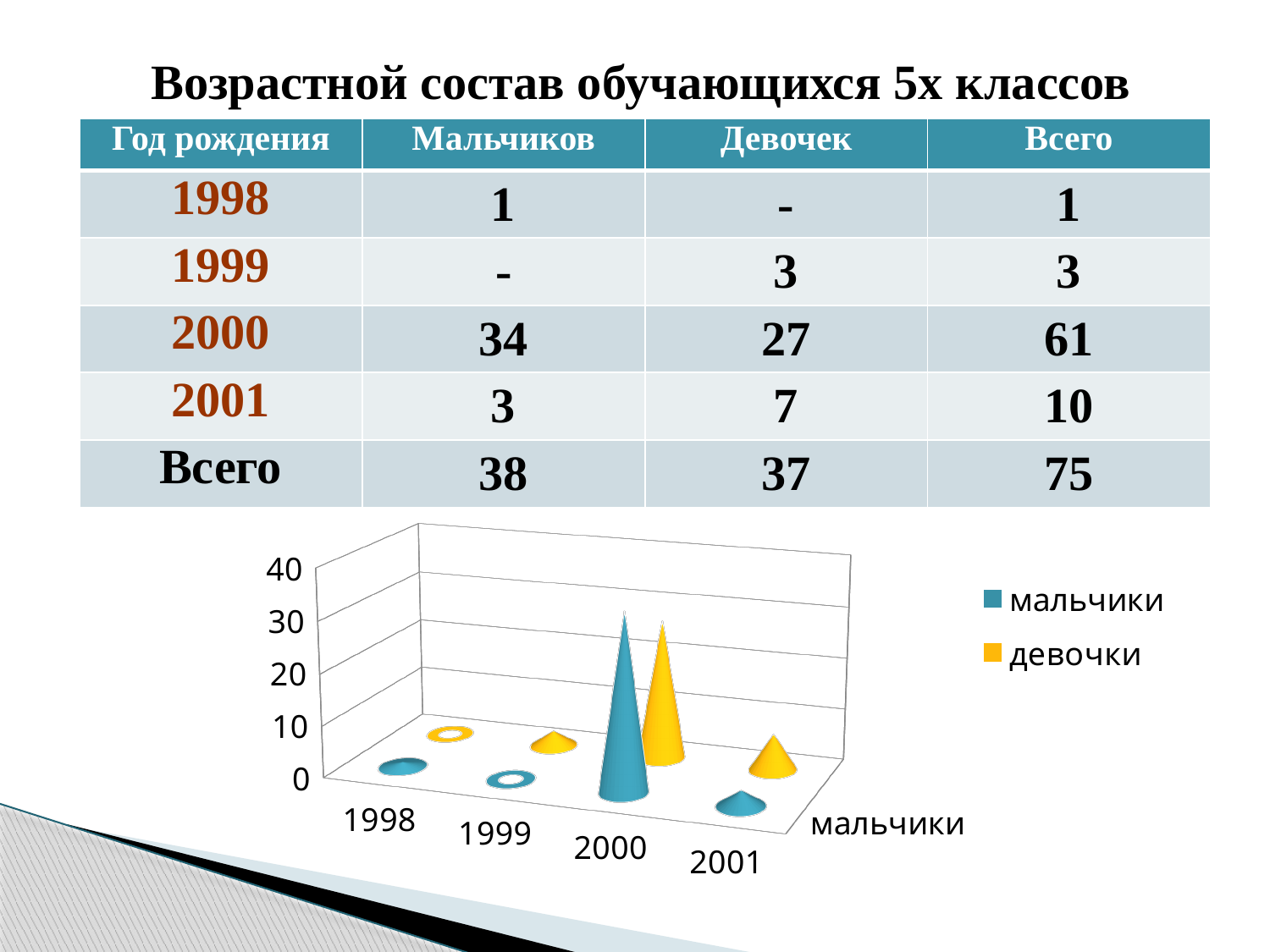
Is the value for девочки in 1999 greater or less than 10? less In 2001, which series has the larger value, мальчики or девочки? девочки Is the value for мальчики in 2001 greater or less than 10? less What kind of chart is shown on the slide? bar chart In 2000, which series has the larger value, мальчики or девочки? мальчики Which colour represents the series девочки in the chart? yellow Which year has the highest value for мальчики in the chart? 2000 Is the value for девочки in 2000 greater or less than 20? greater Which year has the highest value for девочки in the chart? 2000 How many year categories are shown on the chart's x axis? 4 How many series does the chart legend list? 2